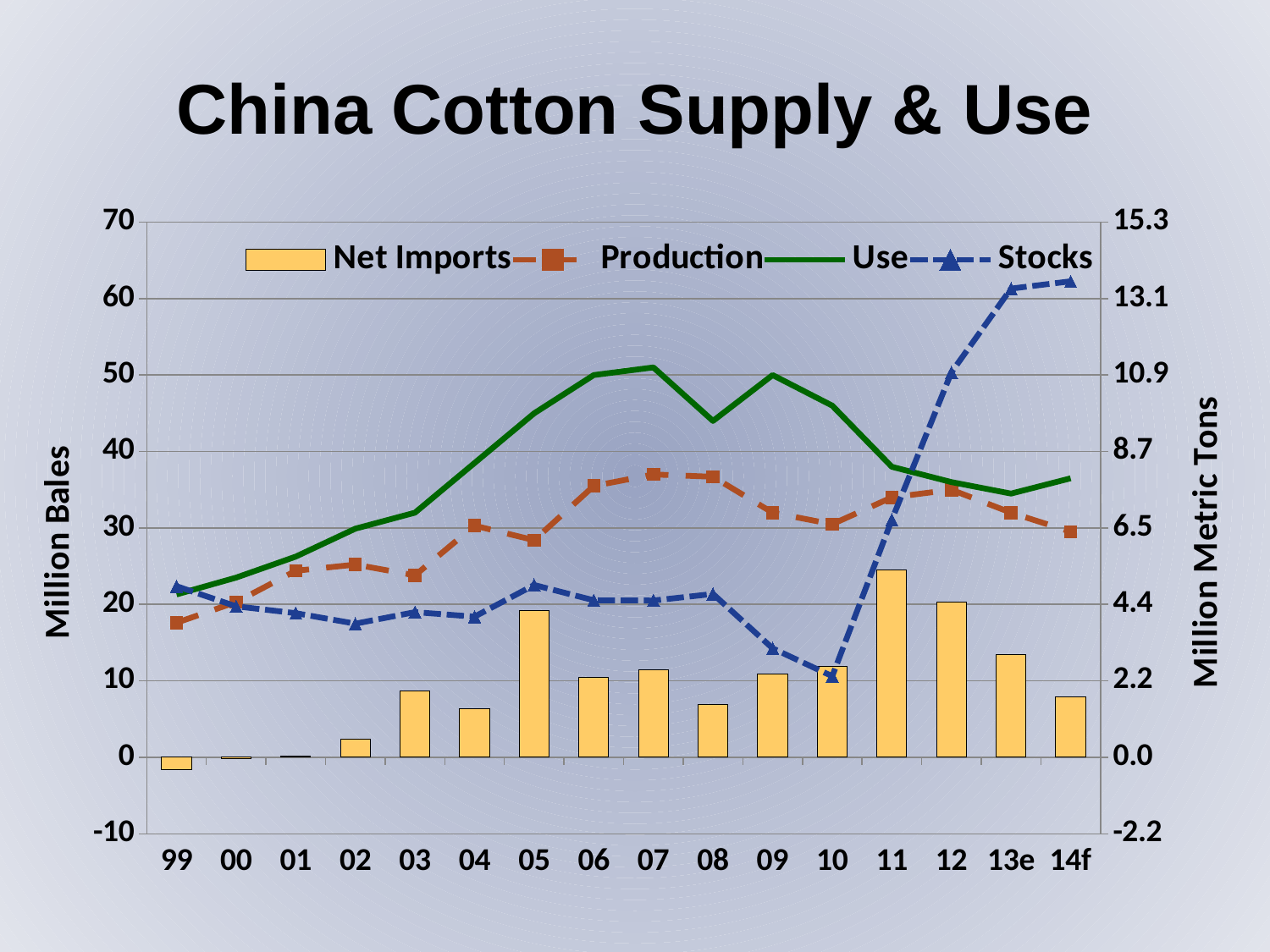
In which year is the Use line at its lowest? 99 How many years are shown along the x axis? 16 What kind of chart is shown on the slide? A combination bar and line chart How many series does the legend list? 4 In which year are Net Imports highest? 11 Is the Stocks value for 12 greater or less than 40 on the left axis? greater What is the label of the right-hand vertical axis? Million Metric Tons In 07, which is larger, Use or Production? Use Is the Production value for 99 greater or less than 20? less In which year is the Stocks line at its lowest? 10 Is the Net Imports value for 11 greater or less than 20? greater Does the Stocks line rise or fall from 10 to 13e? Rise